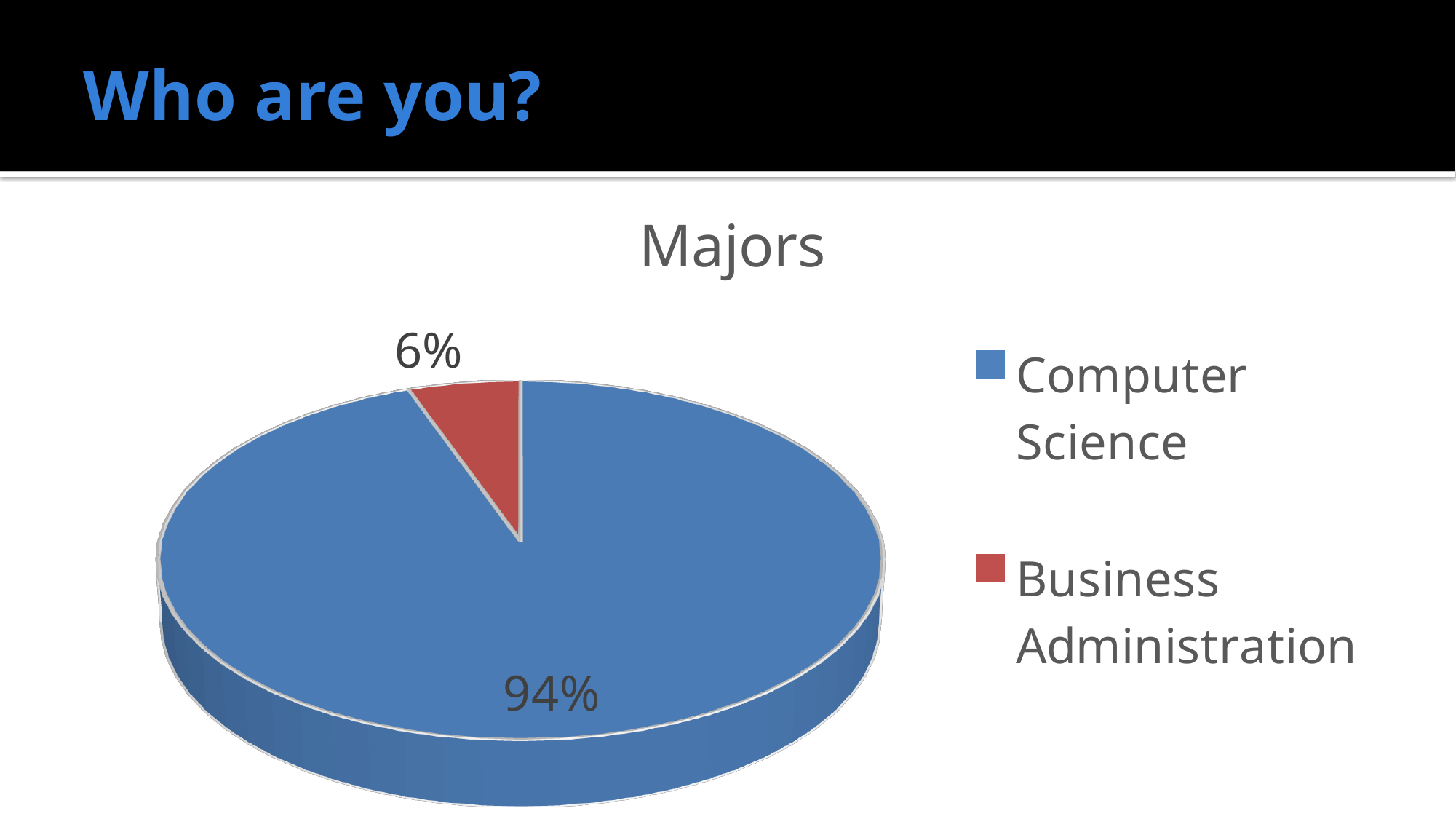
Which category has the largest slice of the pie? Computer Science What kind of chart is shown on the slide? Pie chart What is the difference in percentage points between the Computer Science and Business Administration slices? 88 Which category has the smallest slice of the pie? Business Administration What colour is the Business Administration slice? Red What is the title of the chart? Majors What share of the pie does Computer Science have? 94% Which is larger, the Computer Science slice or the Business Administration slice? Computer Science How many categories are shown in the pie chart? 2 What share of the pie does Business Administration have? 6%